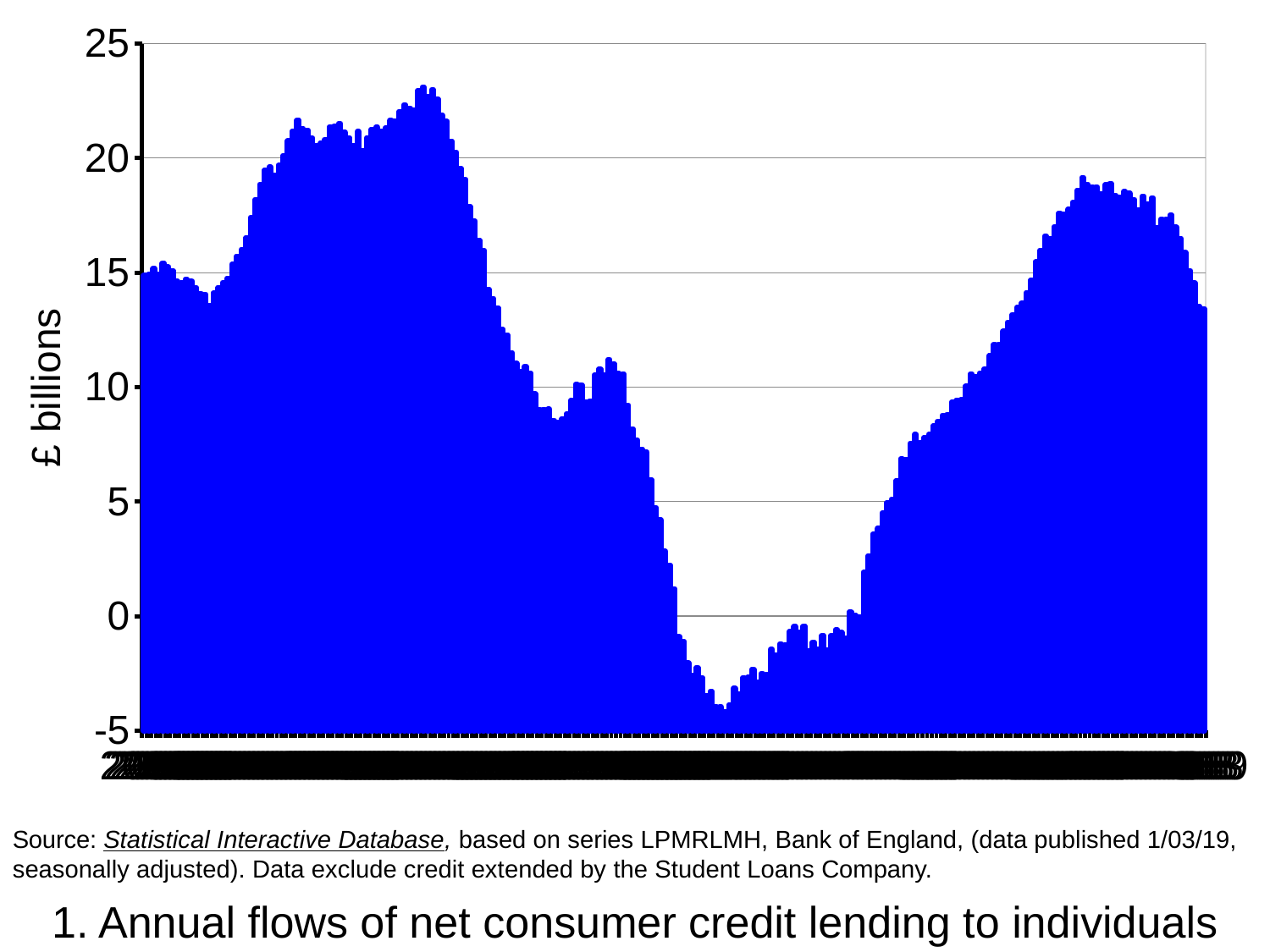
Is the value of the first bar on the left of the chart greater or less than 20? less Is the lowest value plotted on the chart greater or less than -5? greater Is the highest value plotted on the chart greater or less than 25? less What kind of chart is shown on the slide? bar chart Does the chart contain any bars with negative values? Yes What is the highest tick value shown on the vertical axis? 25 What is the label on the vertical axis of the chart? £ billions Which is larger: the highest peak in the left half of the chart or the highest peak in the right half of the chart? the left half